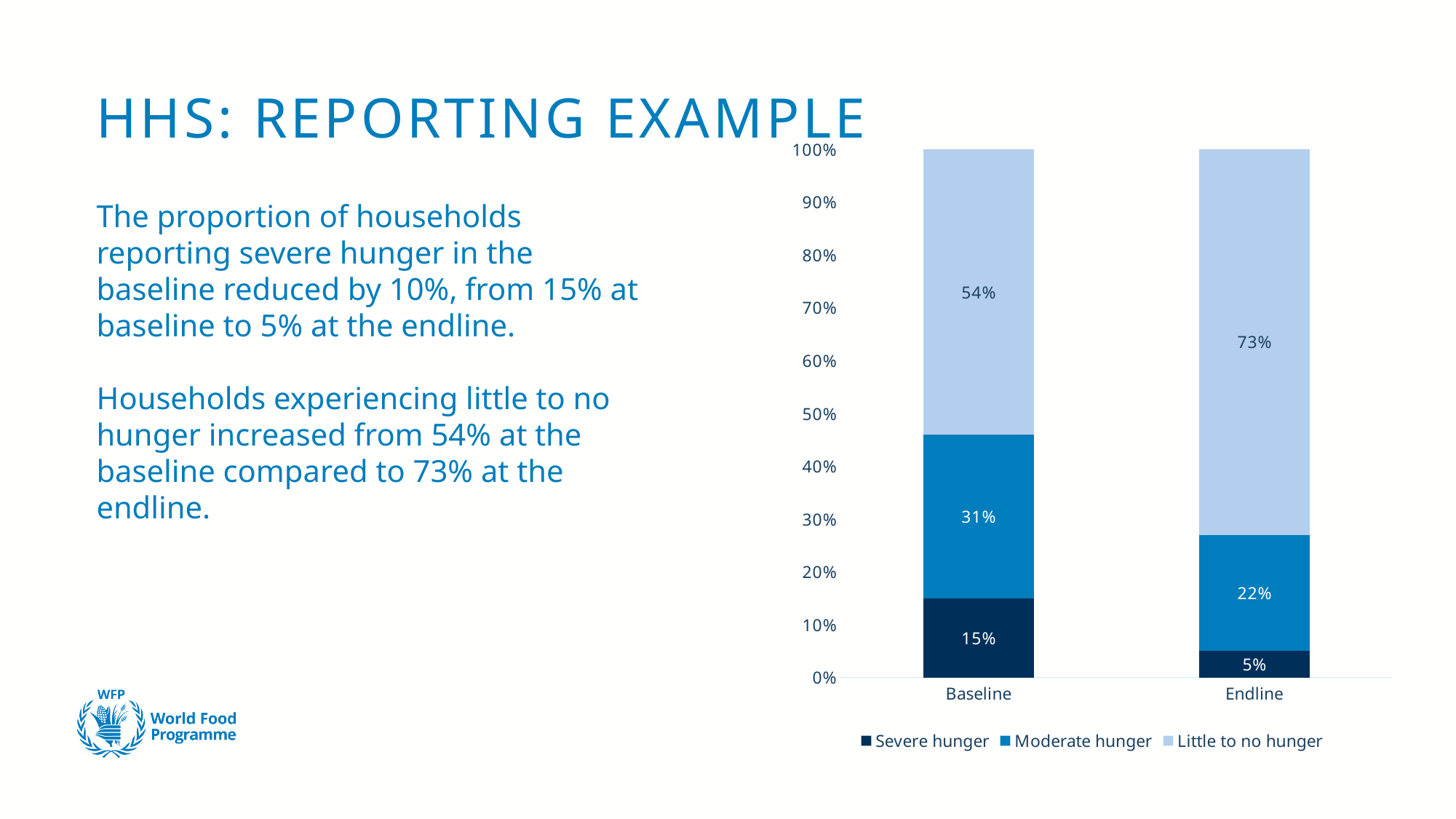
How many series does the legend list? 3 What percentage of households reported severe hunger at Baseline? 15% Which series is shown in the darkest blue colour? Severe hunger What is the value for Moderate hunger at Endline? 22% What is the total of the stacked bar for Baseline? 100% What is the value for Little to no hunger at Baseline? 54% Which category has the higher value for Little to no hunger, Baseline or Endline? Endline By how much did the Little to no hunger share change from Baseline to Endline? 19% How many categories are shown on the x axis? 2 What percentage of households reported severe hunger at Endline? 5% What is the difference between the Moderate hunger values at Baseline and Endline? 9% What kind of chart is shown on the slide? Stacked bar chart